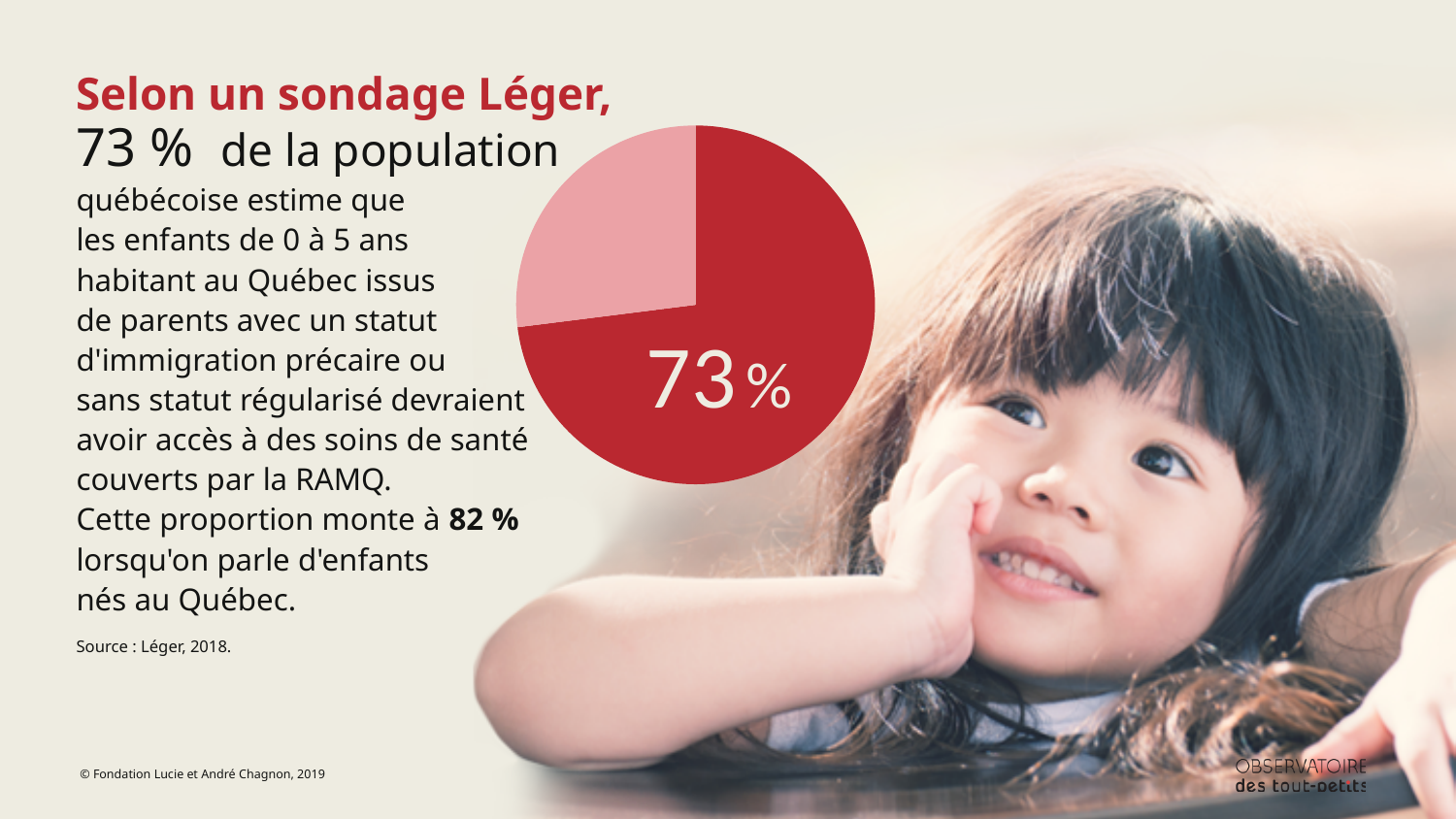
What share of the pie does the light pink slice represent? 27 % How many slices does the pie chart have? 2 What kind of chart is shown on the slide? pie chart Does the pie chart have a legend? No Which slice of the pie chart is larger, the dark red one or the light pink one? the dark red one Is the dark red slice of the pie chart greater or less than 50% of the pie? greater Is the light pink slice of the pie chart greater or less than 50% of the pie? less What share of the pie does the dark red slice represent? 73 % What value is printed on the large dark red slice of the pie chart? 73 % What colour is the slice of the pie chart labelled 73 %? dark red